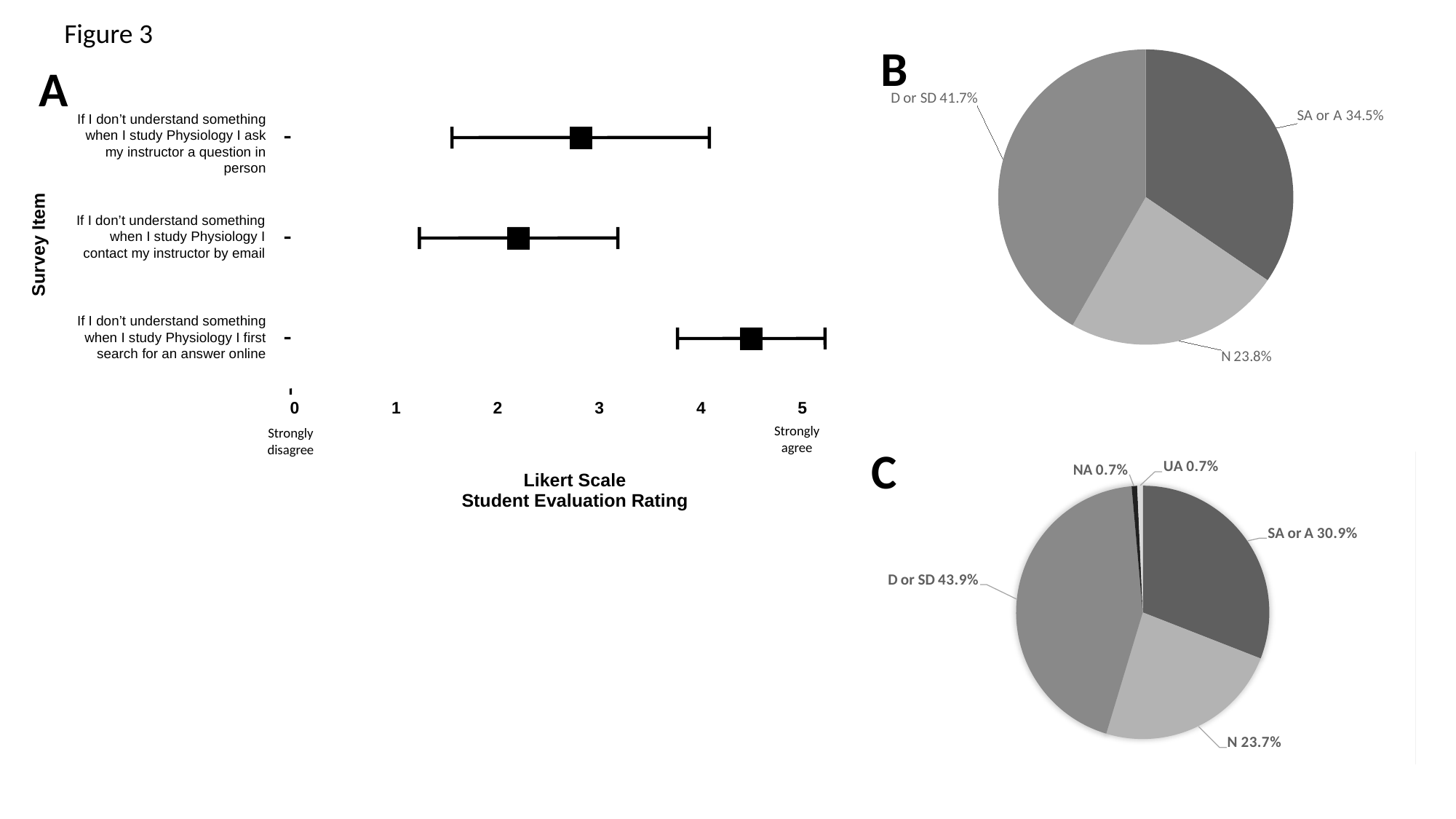
In chart C, what is the difference between the 'D or SD' share and the 'SA or A' share? 13.0% What kind of chart is chart B? Pie chart In chart B, which slice has the smallest share? N How many slices does the pie in chart C have? 5 In chart C, which is larger: the 'SA or A' share or the 'N' share? SA or A In chart B, what percentage is labelled for the 'D or SD' slice? 41.7% In chart C, what percentage is labelled for the 'SA or A' slice? 30.9% In chart A, which survey item has the highest mean Likert rating? If I don't understand something when I study Physiology I first search for an answer online In chart A, is the mean rating for 'If I don't understand something when I study Physiology I contact my instructor by email' greater or less than 3? less In chart C, which slice has the largest share? D or SD In chart B, which slice has the largest share? D or SD In chart B, what is the difference between the 'D or SD' share and the 'N' share? 17.9%